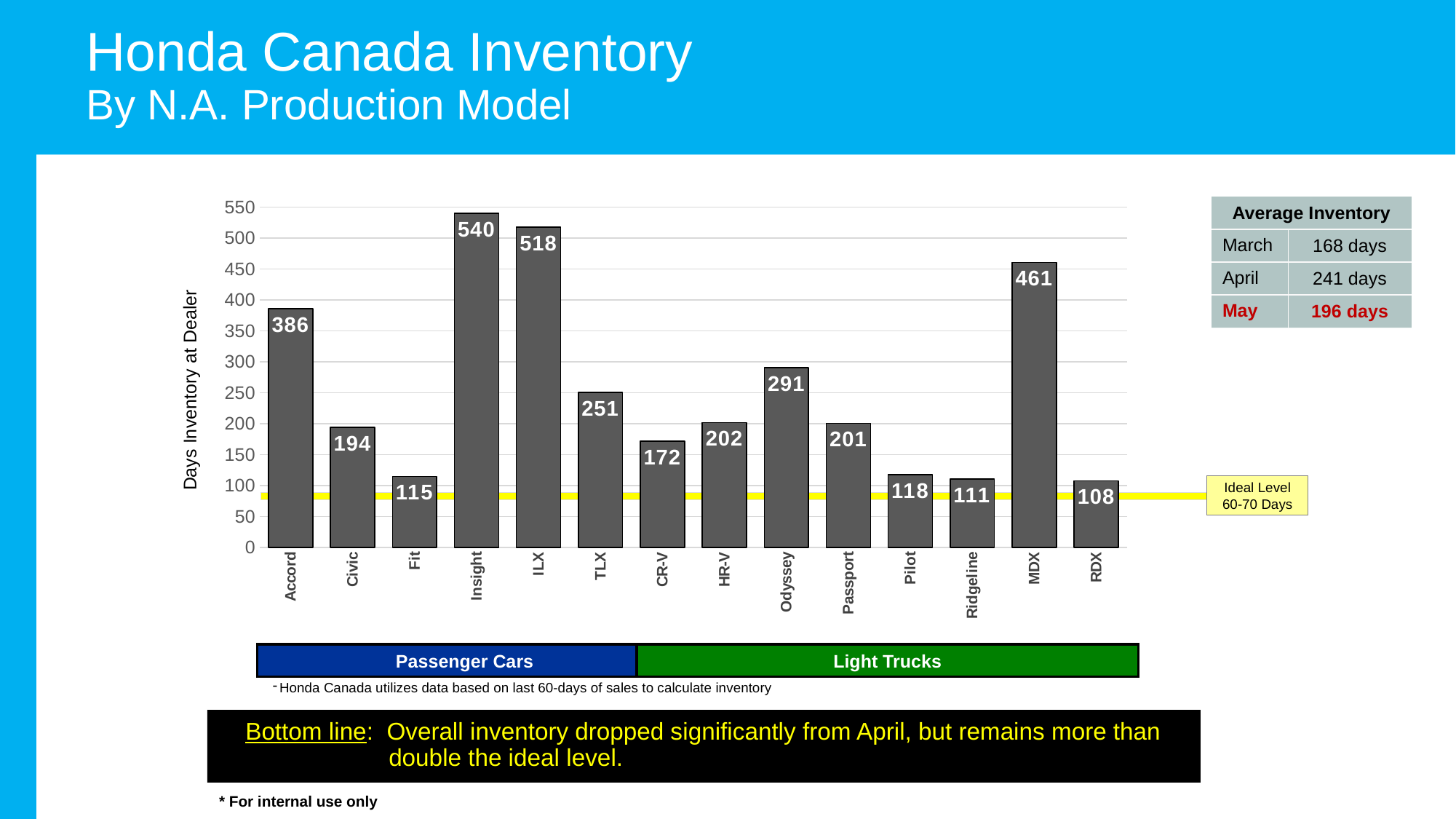
Which has a higher days inventory, the Civic or the Passport? Passport What is the difference in days inventory between the MDX and the Accord? 75 What is the days inventory at dealer for the Ridgeline? 111 What kind of chart is shown on the slide? Bar chart What is the label of the vertical axis of the chart? Days Inventory at Dealer Which model has the lowest days inventory at dealer? RDX What is the difference in days inventory between the Insight and the ILX? 22 Which has a higher days inventory, the TLX or the CR-V? TLX What is the days inventory at dealer for the Odyssey? 291 Which model has the highest days inventory at dealer? Insight What is the days inventory at dealer for the Accord? 386 How many models are shown on the chart? 14